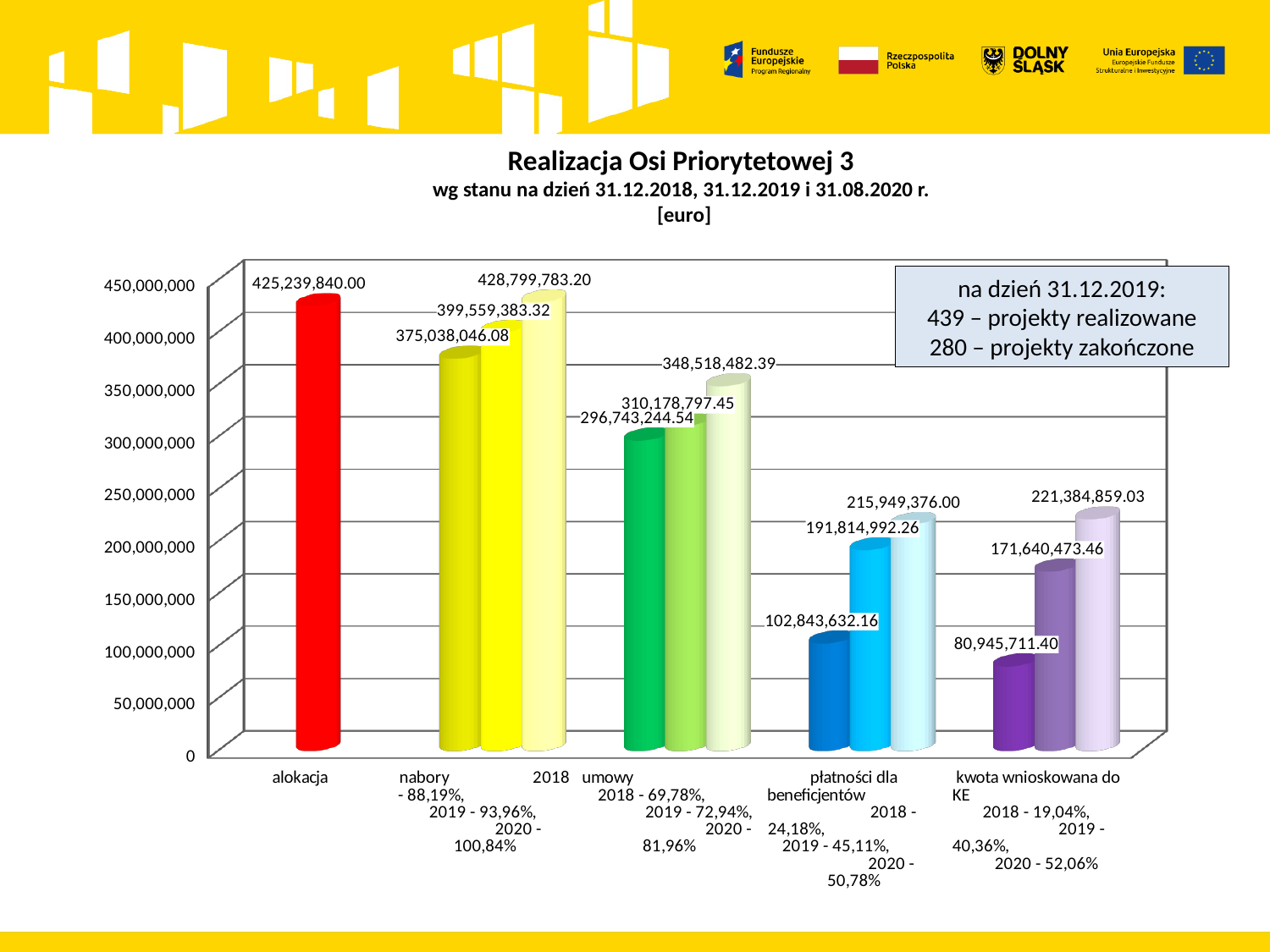
What kind of chart is shown on the slide? bar chart What is the value of the 2018 bar in the kwota wnioskowana do KE category? 80,945,711.40 How many categories are shown on the x axis? 5 What is the value of the 2020 bar in the nabory category? 428,799,783.20 Which is larger: the 2020 bar for płatności dla beneficjentów or the 2020 bar for kwota wnioskowana do KE? kwota wnioskowana do KE 2020 Which bar has the highest value on the chart? nabory 2020 What is the value of the 2018 bar in the umowy category? 296,743,244.54 Which bar has the lowest value on the chart? kwota wnioskowana do KE 2018 What is the value of the alokacja bar? 425,239,840.00 What is the value of the 2019 bar in the płatności dla beneficjentów category? 191,814,992.26 What is the difference between the 2020 and 2018 bars in the płatności dla beneficjentów category? 113,105,743.84 What is the difference between the 2020 and 2018 bars in the nabory category? 53,761,737.12